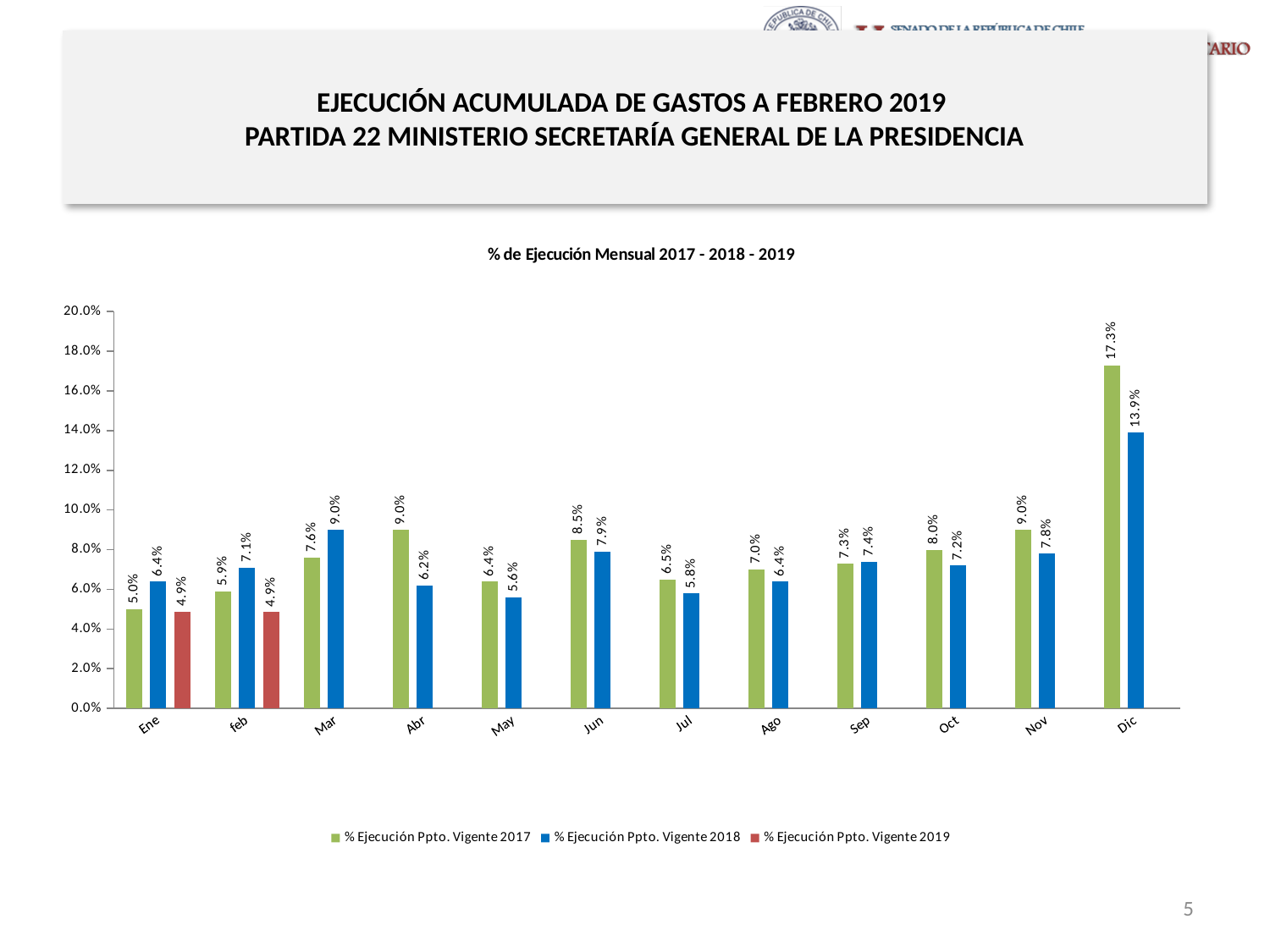
What is the title of the chart? % de Ejecución Mensual 2017 - 2018 - 2019 Is the value for Dic in the 2018 series greater or less than 12.0%? greater What is the value for Dic in the % Ejecución Ppto. Vigente 2017 series? 17.3% What is the value for feb in the % Ejecución Ppto. Vigente 2019 series? 4.9% Which is larger for Abr: the 2017 value or the 2018 value? 2017 value (9.0%) Which month has the lowest value in the % Ejecución Ppto. Vigente 2017 series? Ene How many series does the legend list? 3 Which month has the highest value in the % Ejecución Ppto. Vigente 2018 series? Dic How many months are shown on the x axis? 12 What is the difference between the 2017 and 2018 values for Dic? 3.4% What kind of chart is shown on the slide? Bar chart What is the value for Mar in the % Ejecución Ppto. Vigente 2018 series? 9.0%